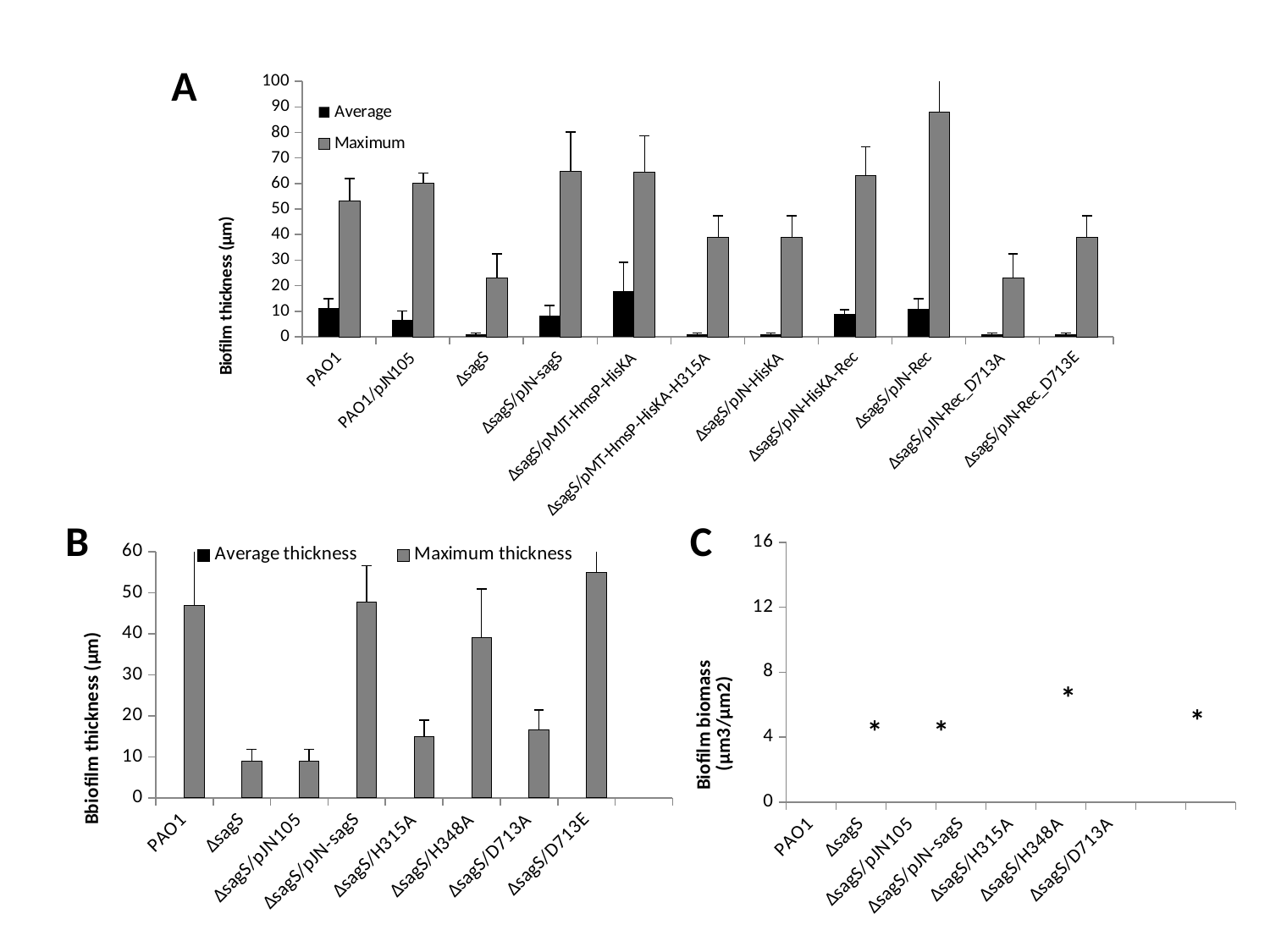
What kind of chart is chart A? bar chart In chart A, how many categories are shown on the x axis? 11 In chart B, how many series does the legend list? 2 In chart A, is the Maximum value for ΔsagS/pJN-Rec greater or less than 80? greater In chart B, how many categories are shown on the x axis? 8 In chart B, which category has the highest Maximum thickness? ΔsagS/D713E In chart A, is the Average value for ΔsagS/pMJT-HmsP-HisKA greater or less than 10? greater In chart A, which has the larger Maximum value: ΔsagS or ΔsagS/pJN-sagS? ΔsagS/pJN-sagS In chart B, is the Maximum thickness for ΔsagS/H315A greater or less than 20? less In chart A, which category has the highest Maximum biofilm thickness? ΔsagS/pJN-Rec In chart A, how many series does the legend list? 2